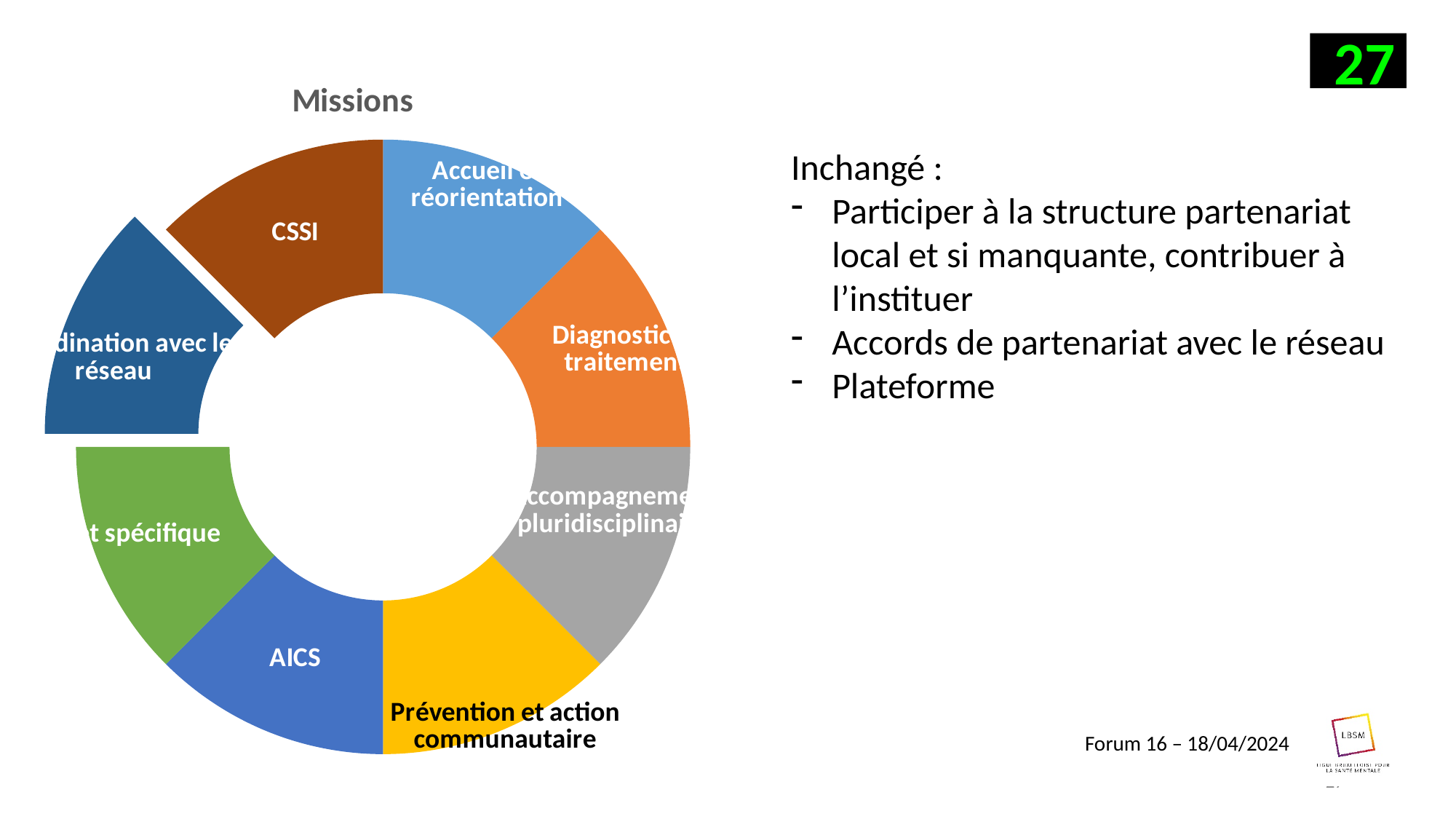
Which segment of the "Missions" chart is pulled out (separated) from the rest of the ring? The dark blue segment labelled "...dination avec le réseau" What kind of chart is shown on the slide? Doughnut chart Which segment of the "Missions" chart is coloured yellow? Prévention et action communautaire Which segment of the "Missions" chart is coloured blue and located at the bottom left, next to the yellow segment? AICS Which segment of the "Missions" chart is coloured orange? Diagnostic et traitement Which segment of the "Missions" chart is coloured brown? CSSI How many segments does the "Missions" doughnut chart have? 8 Which segment of the "Missions" chart is coloured grey? Accompagnement pluridisciplinaire What is the title of the chart on the slide? Missions